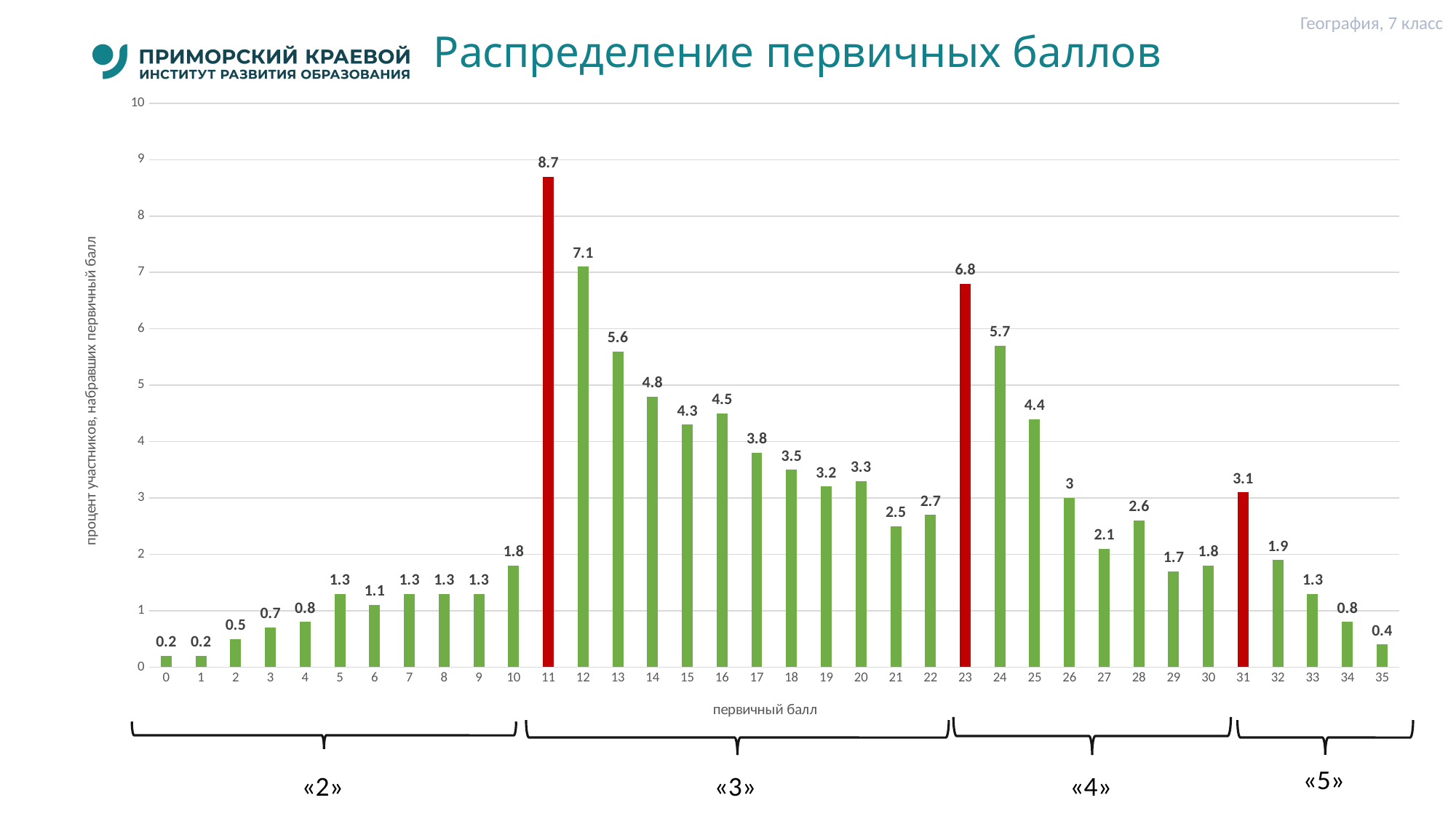
Which primary score has the highest value? 11 Do the values rise or fall from primary score 11 to primary score 22? fall What is the lowest value shown on the chart? 0.2 Which primary scores are shown with red bars? 11, 23 and 31 What is the value for primary score 23? 6.8 What is the value for primary score 16? 4.5 How many primary score categories are shown on the x axis? 36 What is the value for primary score 11? 8.7 What kind of chart is shown on the slide? bar chart Which is larger, the value for primary score 12 or for primary score 24? 12 What is the difference between the values for primary scores 11 and 23? 1.9 What is the value for primary score 31? 3.1